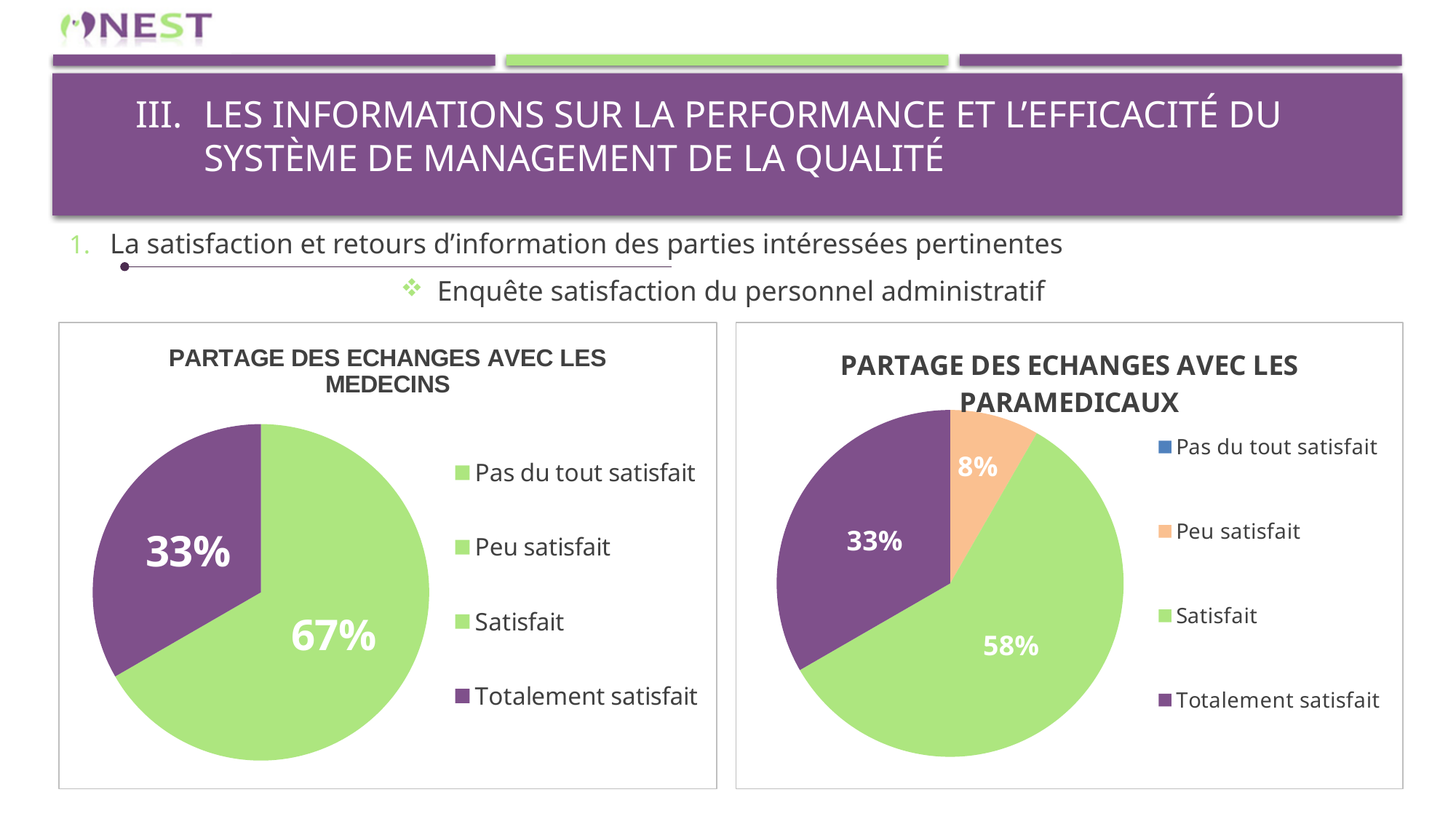
In the 'PARTAGE DES ECHANGES AVEC LES PARAMEDICAUX' chart, which category has the largest slice? Satisfait In the 'PARTAGE DES ECHANGES AVEC LES PARAMEDICAUX' chart, what share is shown for 'Peu satisfait'? 8% In the 'PARTAGE DES ECHANGES AVEC LES PARAMEDICAUX' chart, which is larger: 'Totalement satisfait' or 'Peu satisfait'? Totalement satisfait What type of chart is used in the 'PARTAGE DES ECHANGES AVEC LES MEDECINS' chart? Pie chart In the 'PARTAGE DES ECHANGES AVEC LES MEDECINS' chart, what share is shown for 'Totalement satisfait'? 33% In the 'PARTAGE DES ECHANGES AVEC LES PARAMEDICAUX' chart, what is the difference between 'Satisfait' and 'Totalement satisfait'? 25% In the 'PARTAGE DES ECHANGES AVEC LES MEDECINS' chart, what is the difference between the two labelled slices? 34% In the 'PARTAGE DES ECHANGES AVEC LES PARAMEDICAUX' chart, what share is shown for 'Satisfait'? 58% How many entries does the legend of the 'PARTAGE DES ECHANGES AVEC LES MEDECINS' chart list? 4 In the 'PARTAGE DES ECHANGES AVEC LES PARAMEDICAUX' chart, what share is shown for 'Totalement satisfait'? 33% In the 'PARTAGE DES ECHANGES AVEC LES PARAMEDICAUX' chart, which category has the smallest slice? Peu satisfait In the 'PARTAGE DES ECHANGES AVEC LES MEDECINS' chart, what is the value of the largest slice? 67%